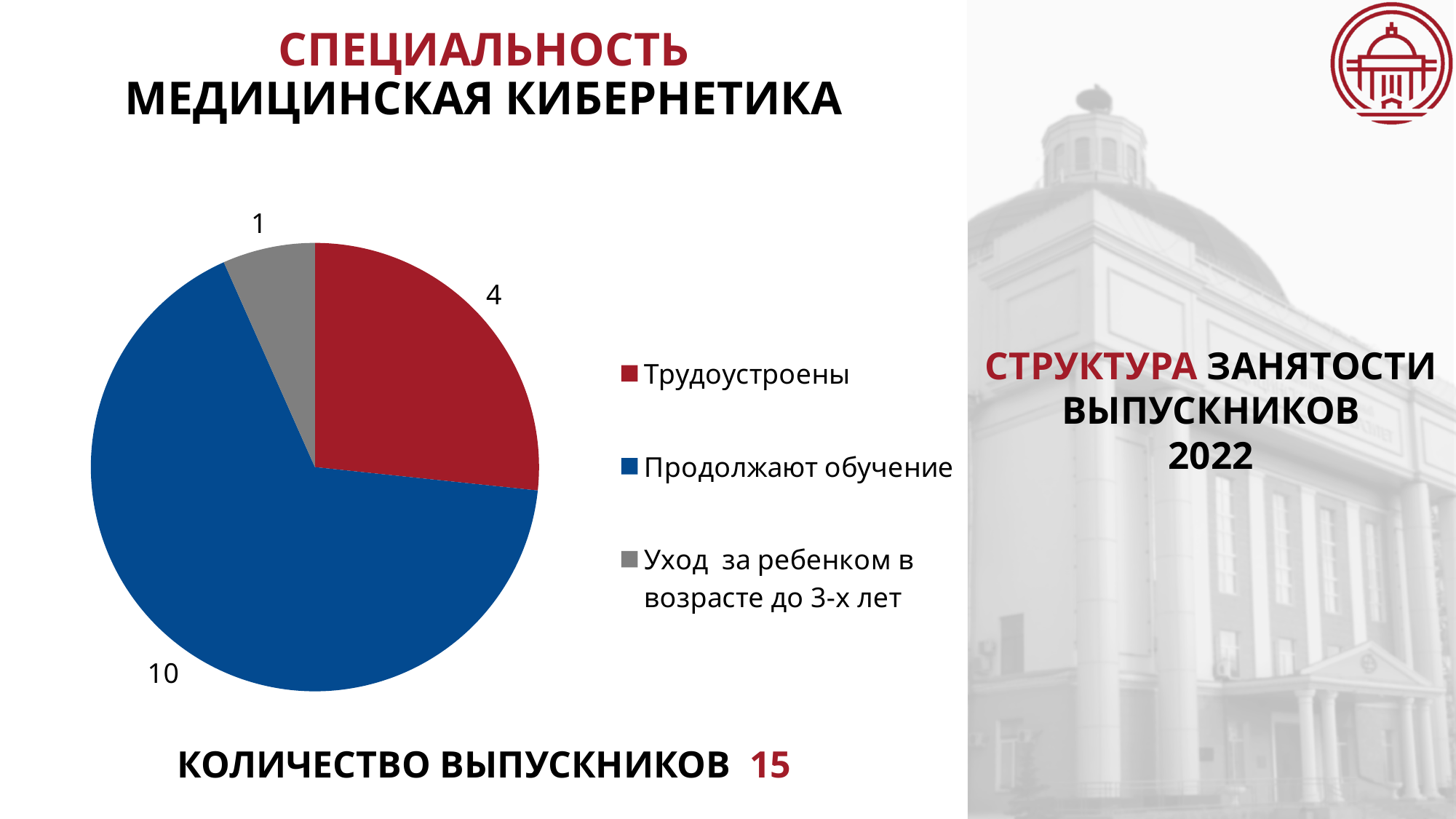
What is the total of all slices in the pie chart? 15 Which category has the largest slice in the pie chart? Продолжают обучение What is the value for Трудоустроены in the pie chart? 4 What type of chart is shown on the slide? pie chart What colour is the slice for Продолжают обучение? blue What is the value for Уход за ребенком в возрасте до 3-х лет in the pie chart? 1 Which is larger: the value for Трудоустроены or the value for Уход за ребенком в возрасте до 3-х лет? Трудоустроены How many slices does the pie chart have? 3 Which category has the smallest slice in the pie chart? Уход за ребенком в возрасте до 3-х лет What is the value for Продолжают обучение in the pie chart? 10 How many entries does the legend of the pie chart list? 3 What is the difference between the values for Продолжают обучение and Трудоустроены? 6